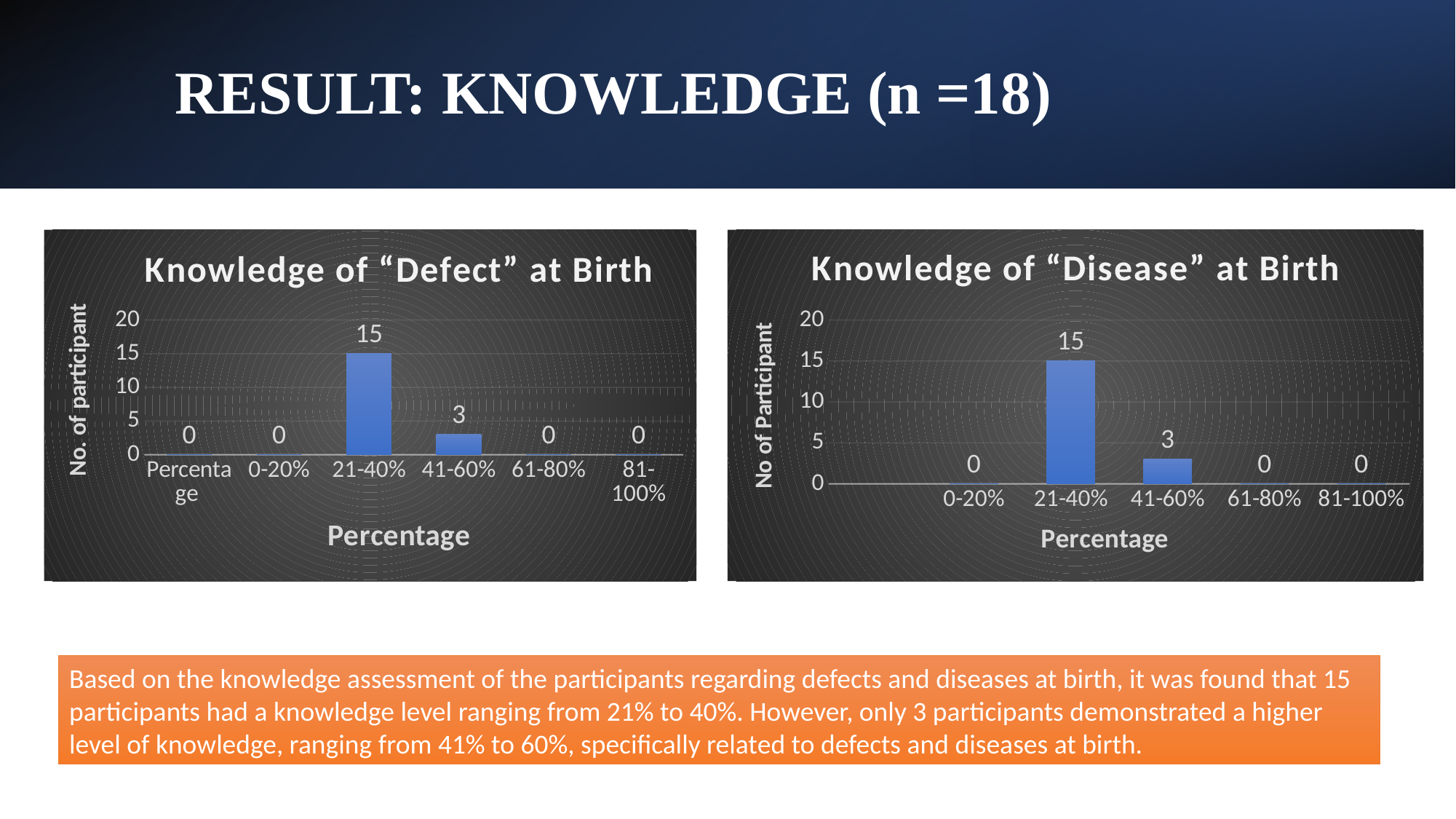
In the "Knowledge of "Disease" at Birth" chart, what is the value for 21-40%? 15 In the "Knowledge of "Disease" at Birth" chart, what is the difference between the values for 21-40% and 41-60%? 12 In the "Knowledge of "Defect" at Birth" chart, which is larger, the value for 21-40% or the value for 41-60%? 21-40% In the "Knowledge of "Defect" at Birth" chart, which category has the highest value? 21-40% In the "Knowledge of "Defect" at Birth" chart, what is the value for 41-60%? 3 In the "Knowledge of "Disease" at Birth" chart, what is the value for 61-80%? 0 How many categories are shown on the x axis of the "Knowledge of "Defect" at Birth" chart? 6 How many categories are shown on the x axis of the "Knowledge of "Disease" at Birth" chart? 5 In the "Knowledge of "Defect" at Birth" chart, what is the value for 21-40%? 15 What is the y-axis label of the "Knowledge of "Defect" at Birth" chart? No. of participant In the "Knowledge of "Disease" at Birth" chart, which category has the highest value? 21-40% What type of chart is the "Knowledge of "Disease" at Birth" chart? Bar chart